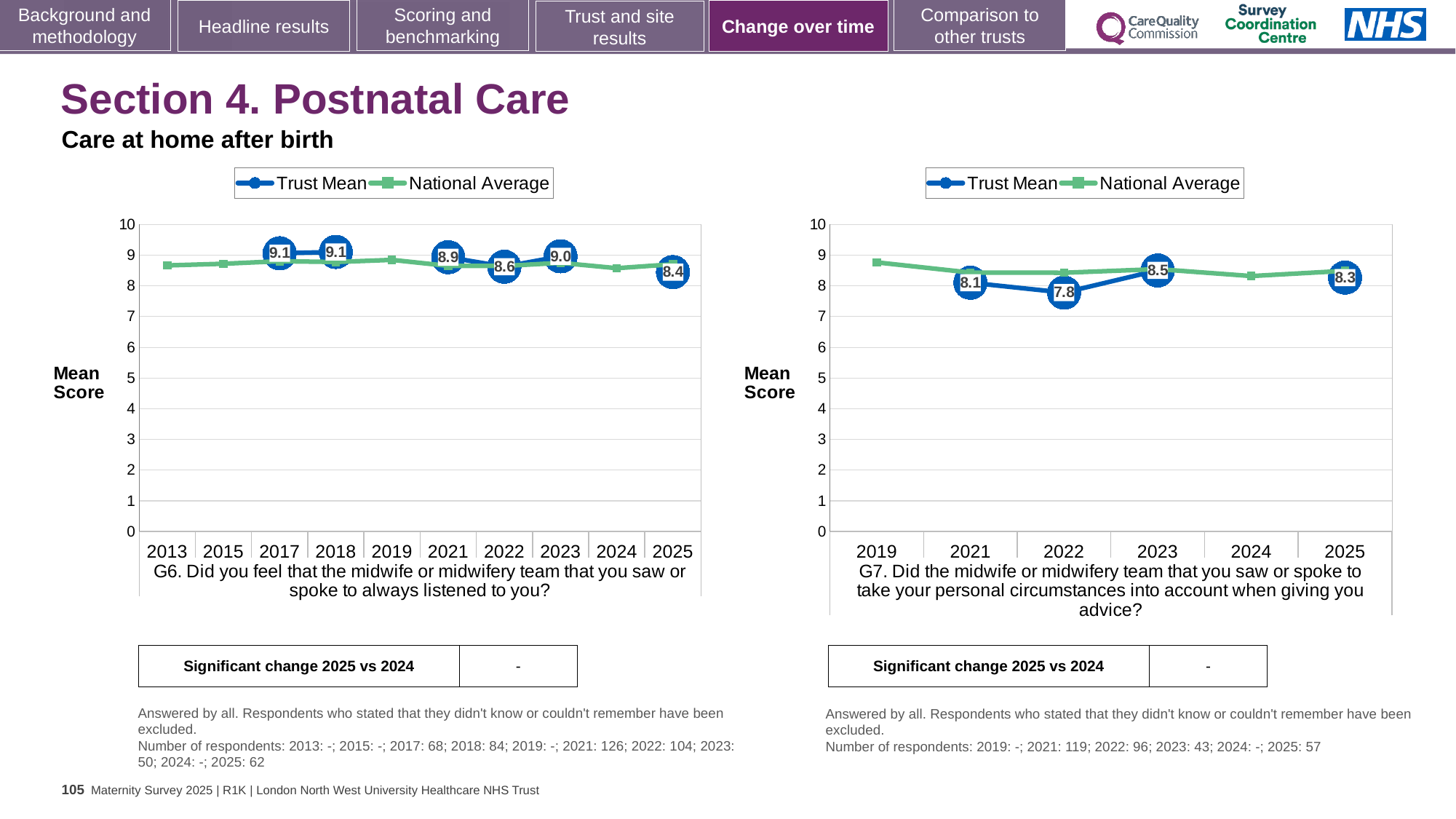
In the G6 chart on the left, how many years are shown on the x axis? 10 In the G7 chart on the right, is the Trust Mean higher in 2021 or in 2025? 2025 In the G7 chart on the right, which year has the highest labelled Trust Mean? 2023 In the G6 chart on the left, what is the Trust Mean for 2022? 8.6 How many series does the legend of the G7 chart on the right list? 2 In the G6 chart on the left, what is the difference between the Trust Mean for 2023 and for 2025? 0.6 In the G6 chart on the left, is the National Average for 2013 greater or less than 8? greater In the G6 chart on the left, which year has the lowest labelled Trust Mean? 2025 In the G7 chart on the right, what is the Trust Mean for 2022? 7.8 In the G6 chart on the left, what is the Trust Mean for 2025? 8.4 In the G7 chart on the right, which year has the lowest labelled Trust Mean? 2022 In the G7 chart on the right, what is the difference between the Trust Mean for 2023 and for 2022? 0.7